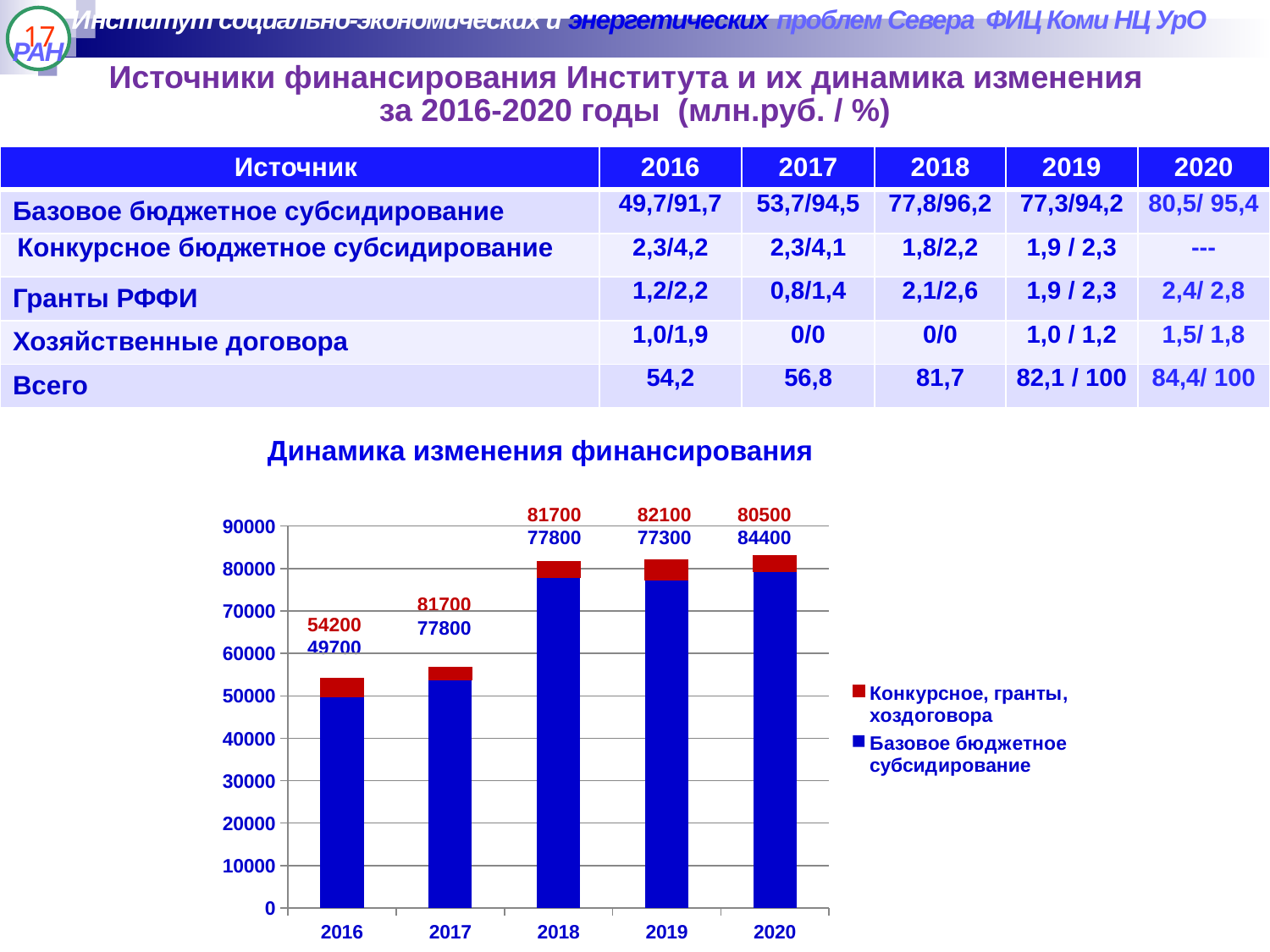
In the chart "Динамика изменения финансирования", what is the blue data label shown for 2019? 77300 How many series does the legend of the chart "Динамика изменения финансирования" list? 2 In the chart "Динамика изменения финансирования", is the total height of the 2018 bar greater or less than 80000? greater In the chart "Динамика изменения финансирования", what is the red data label shown for 2019? 82100 What kind of chart is shown under the heading "Динамика изменения финансирования"? bar chart In the chart "Динамика изменения финансирования", is the total height of the 2017 bar greater or less than 60000? less How many years are shown on the x axis of the chart "Динамика изменения финансирования"? 5 Which series in the chart "Динамика изменения финансирования" is shown in blue? Базовое бюджетное субсидирование In the chart "Динамика изменения финансирования", what is the red data label shown for 2016? 54200 In the chart "Динамика изменения финансирования", which bar is taller, 2016 or 2018? 2018 In the chart "Динамика изменения финансирования", what is the blue data label shown for 2016? 49700 In the chart "Динамика изменения финансирования", which year has the shortest stacked bar? 2016